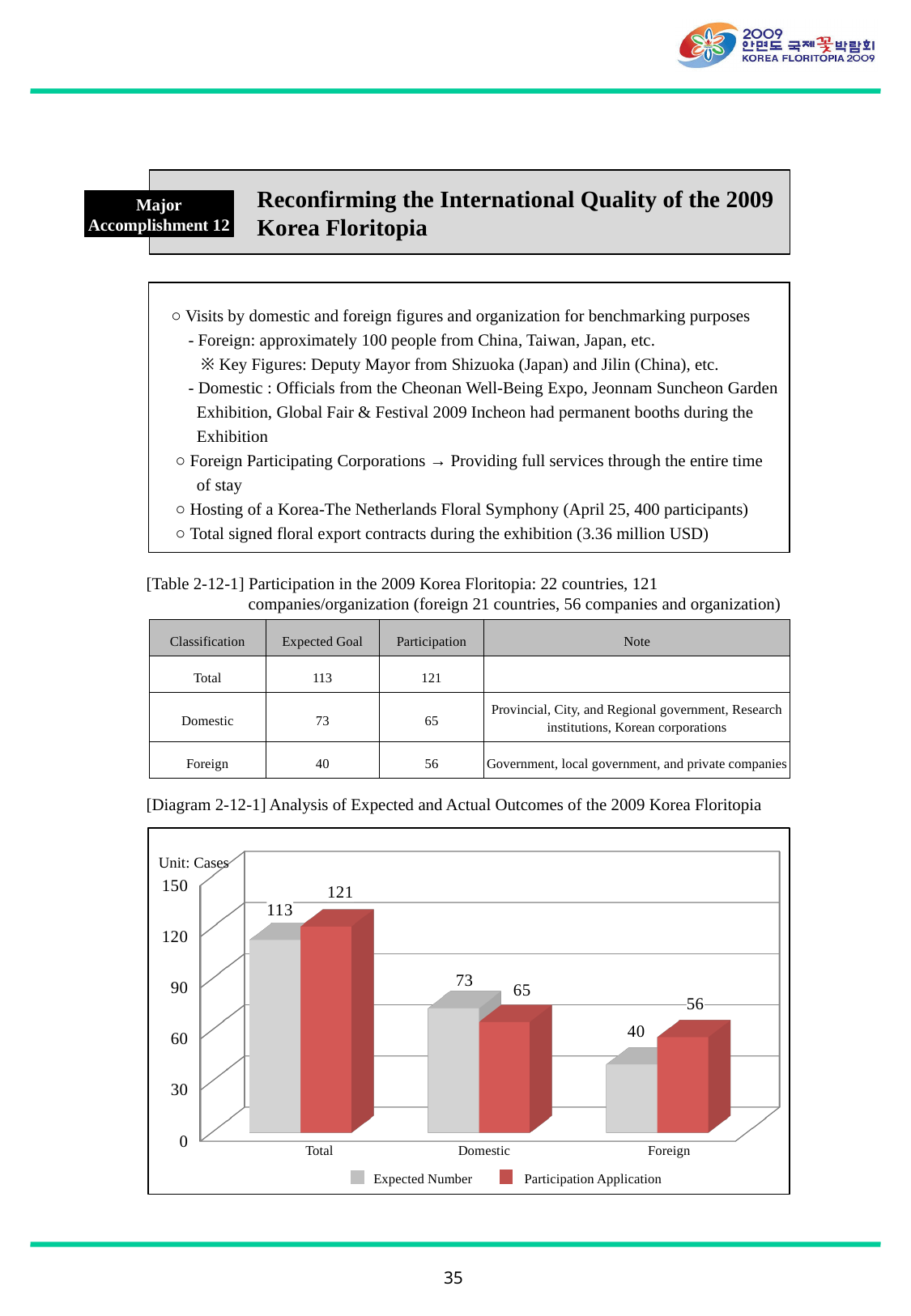
What is the Expected Number for Total in the chart? 113 For Domestic, which is larger: Expected Number or Participation Application? Expected Number What unit is stated in the top-left corner of the chart? Cases Which category has the highest Participation Application value? Total What is the difference between the Participation Application and Expected Number values for Foreign? 16 What is the Expected Number for Domestic in the chart? 73 Is the Participation Application value for Total greater or less than 90? greater How many categories are shown on the x axis of the chart? 3 How many series does the chart legend list? 2 What is the Participation Application value for Foreign in the chart? 56 What kind of chart is shown in Diagram 2-12-1? Bar chart Which category has the lowest Expected Number? Foreign